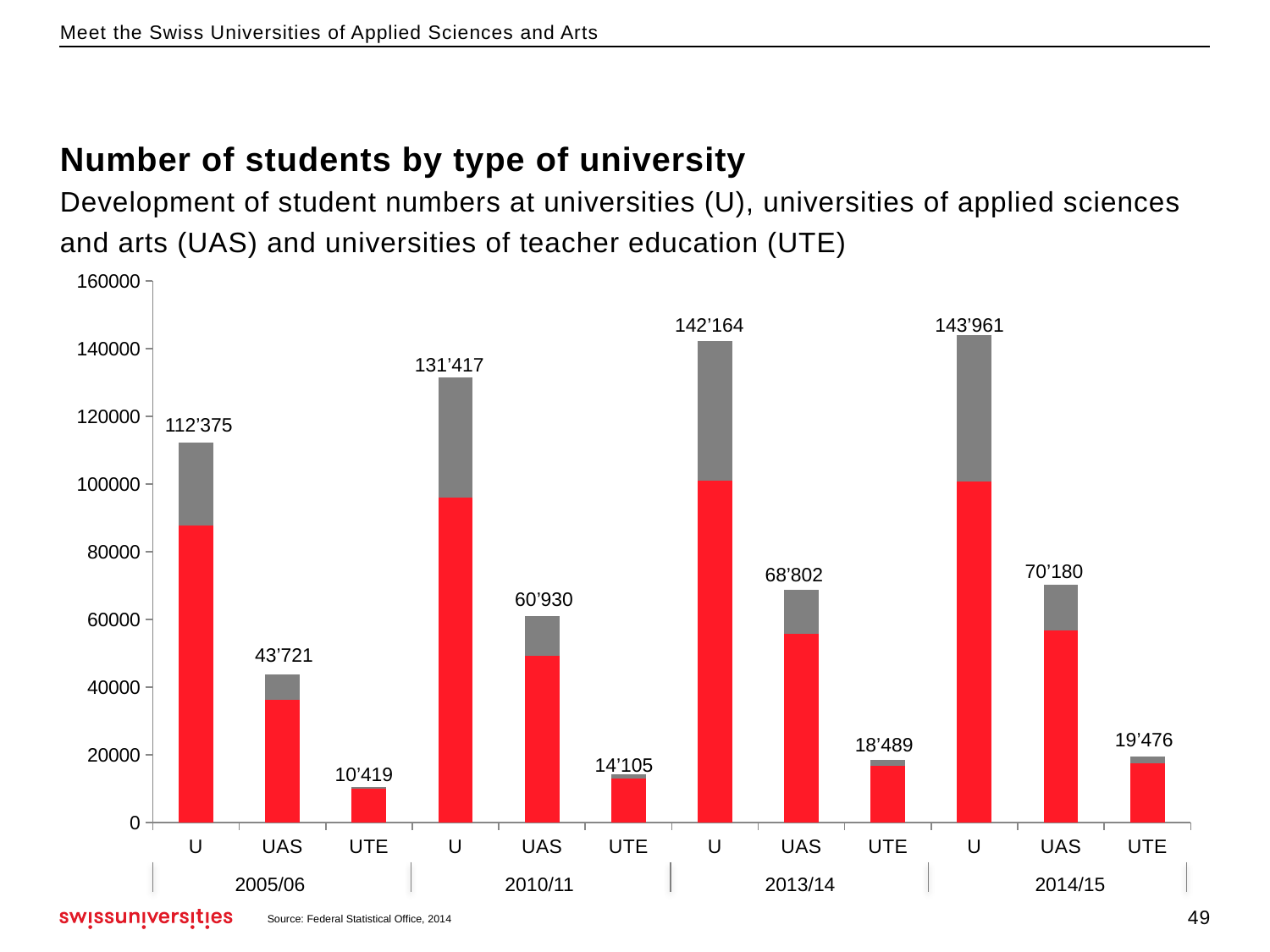
Which bar has the lowest total value in the chart? UTE in 2005/06 What is the total number of students at universities of teacher education (UTE) in 2013/14? 18'489 What is the total number of students at universities (U) in 2005/06? 112'375 Which bar has the highest total value in the chart? U in 2014/15 What type of chart is shown on the slide? Stacked bar chart What is the total number of students at universities of applied sciences and arts (UAS) in 2010/11? 60'930 Do the totals for universities (U) rise or fall from 2005/06 to 2014/15? Rise How many bars are plotted in the chart? 12 By how much did the total number of students at universities (U) increase from 2005/06 to 2014/15? 31'586 What is the difference between the UAS totals in 2014/15 and 2013/14? 1'378 What is the total number of students at universities (U) in 2014/15? 143'961 Which is larger: the UAS total in 2013/14 or the UAS total in 2014/15? UAS total in 2014/15